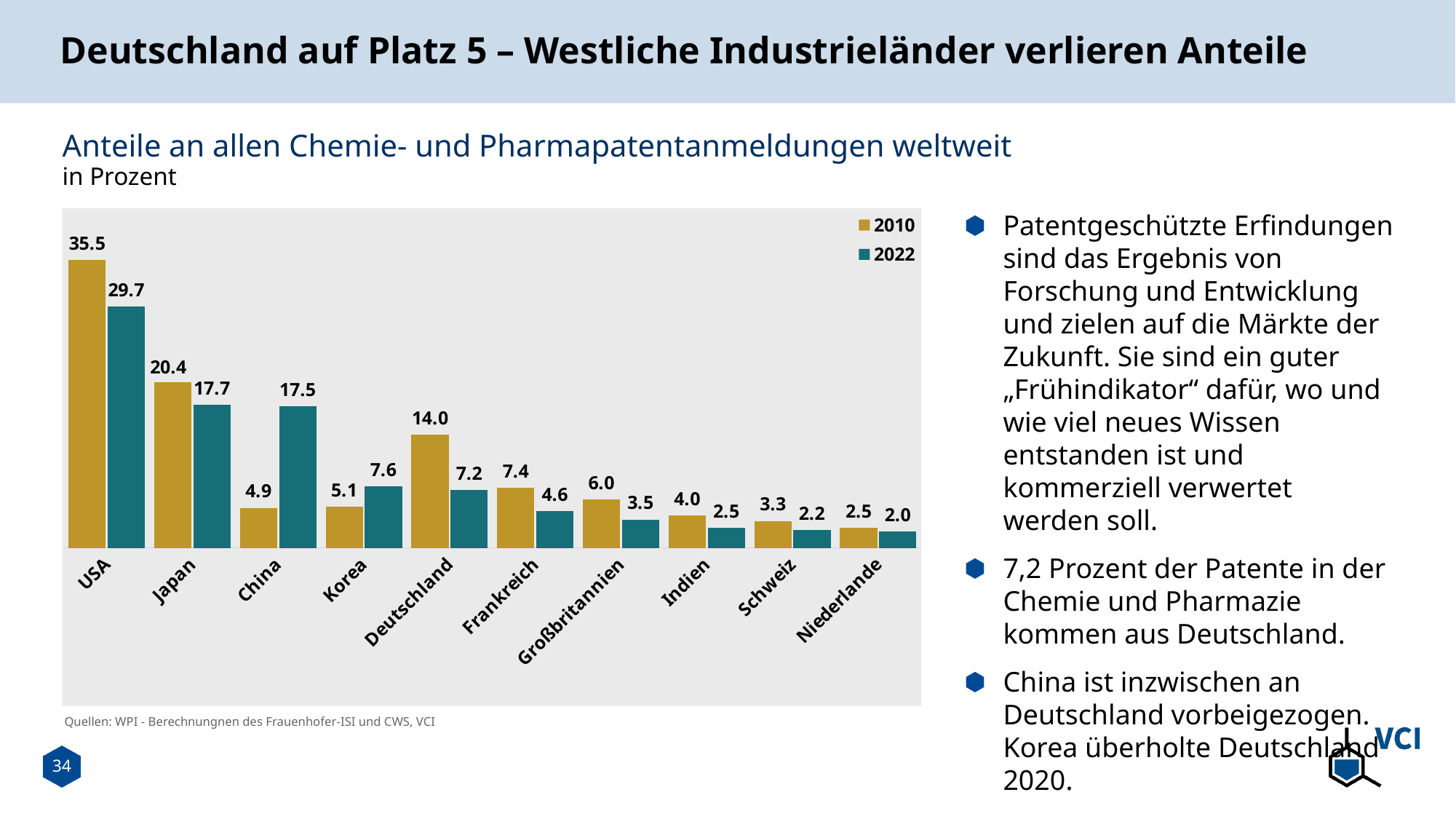
Which country has the lowest 2022 value? Niederlande What is the 2010 value for USA? 35.5 What is the 2022 value for China? 17.5 How many series does the legend list? 2 What is the 2022 value for Deutschland? 7.2 What is the difference between the 2010 and 2022 values for China? 12.6 Which is larger, the 2022 value for Korea or the 2022 value for Deutschland? Korea Which years are listed in the legend? 2010 and 2022 What is the difference between the 2010 and 2022 values for Deutschland? 6.8 What kind of chart is shown? bar chart How many countries are shown on the x axis? 10 Which country has the highest 2022 value? USA